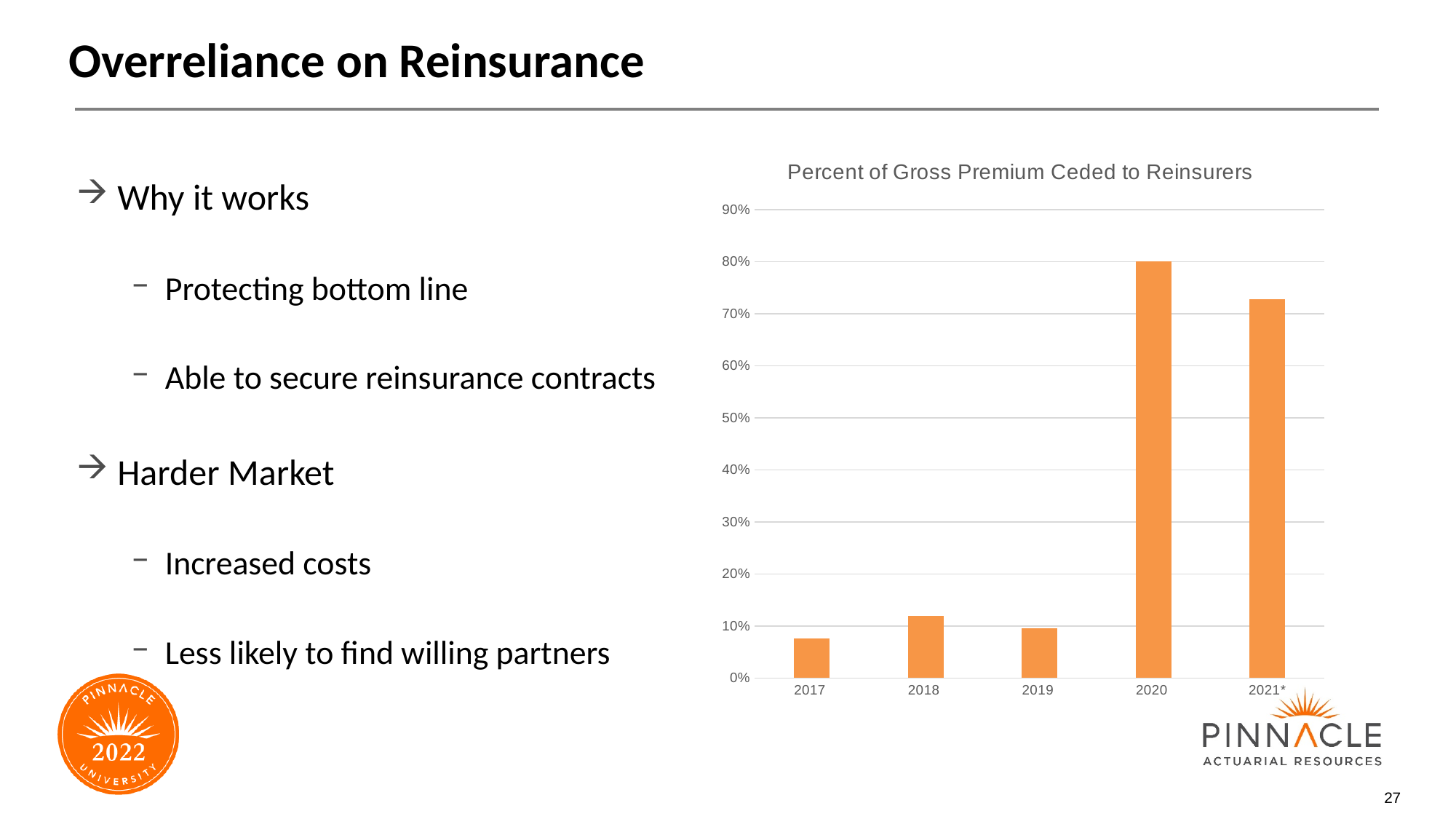
How many years are shown on the x axis of the chart? 5 Which year has the highest percent of gross premium ceded to reinsurers? 2020 Is the value for 2021* greater or less than 80%? less Is the value for 2020 greater or less than 70%? greater Does the percent ceded to reinsurers rise or fall from 2019 to 2020? Rise Which year has the lowest percent of gross premium ceded to reinsurers? 2017 Is the value for 2018 greater or less than 10%? greater What kind of chart is shown on the slide? Bar chart Which year has a larger value, 2020 or 2021*? 2020 Which year has a larger value, 2018 or 2019? 2018 What is the title of the chart? Percent of Gross Premium Ceded to Reinsurers